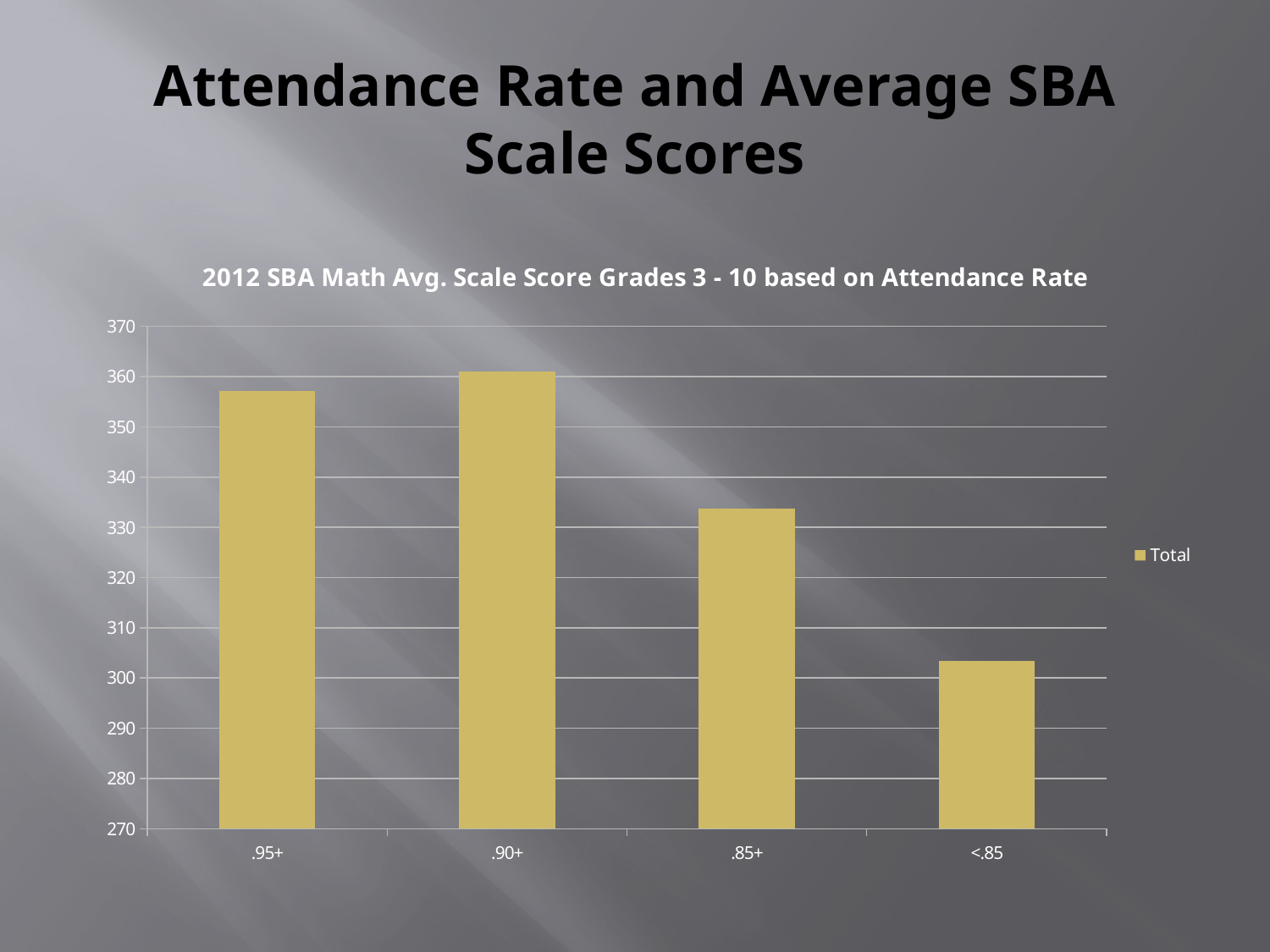
Which attendance rate category has the highest average scale score? .90+ How many series does the legend list? 1 Which is larger, the value for .85+ or the value for <.85? .85+ What is the title of the chart? 2012 SBA Math Avg. Scale Score Grades 3 - 10 based on Attendance Rate Is the value for .85+ greater or less than 340? less Is the value for .95+ greater or less than 350? greater How many attendance rate categories are shown on the x axis? 4 Is the value for <.85 greater or less than 310? less What kind of chart is shown on the slide? bar chart Which attendance rate category has the lowest average scale score? <.85 What is the name of the series in the legend? Total